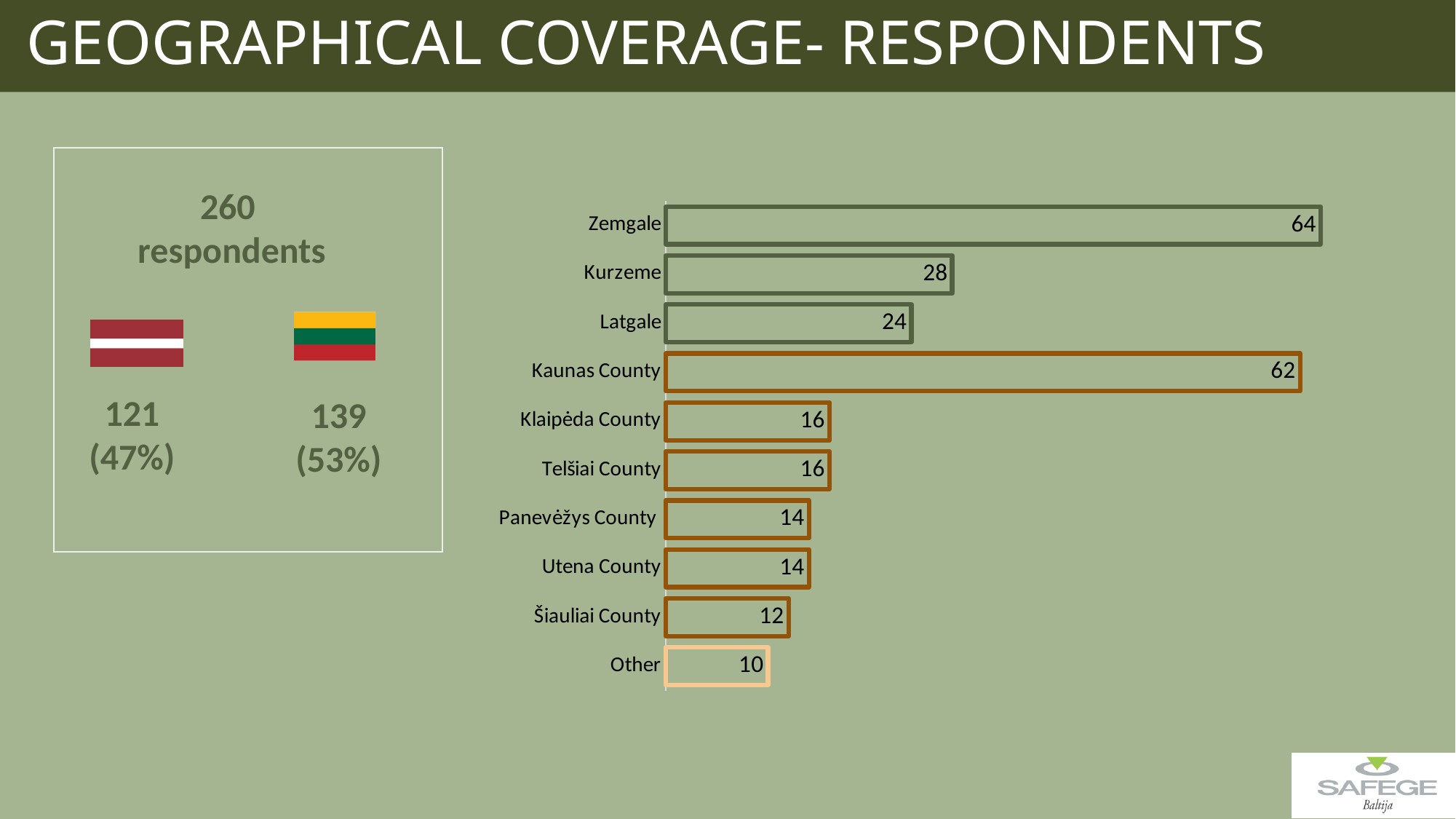
What is the value for Šiauliai County? 12 Which category has the lowest value? Other What is the value for Kaunas County? 62 What is the value for Latgale? 24 Which is larger, the value for Kurzeme or the value for Klaipėda County? Kurzeme What is the value for Zemgale? 64 What kind of chart is shown on the slide? Bar chart What is the difference between the values for Zemgale and Kaunas County? 2 What is the difference between the values for Kurzeme and Latgale? 4 What is the value for Utena County? 14 Which category has the highest value? Zemgale How many categories are shown in the chart? 10